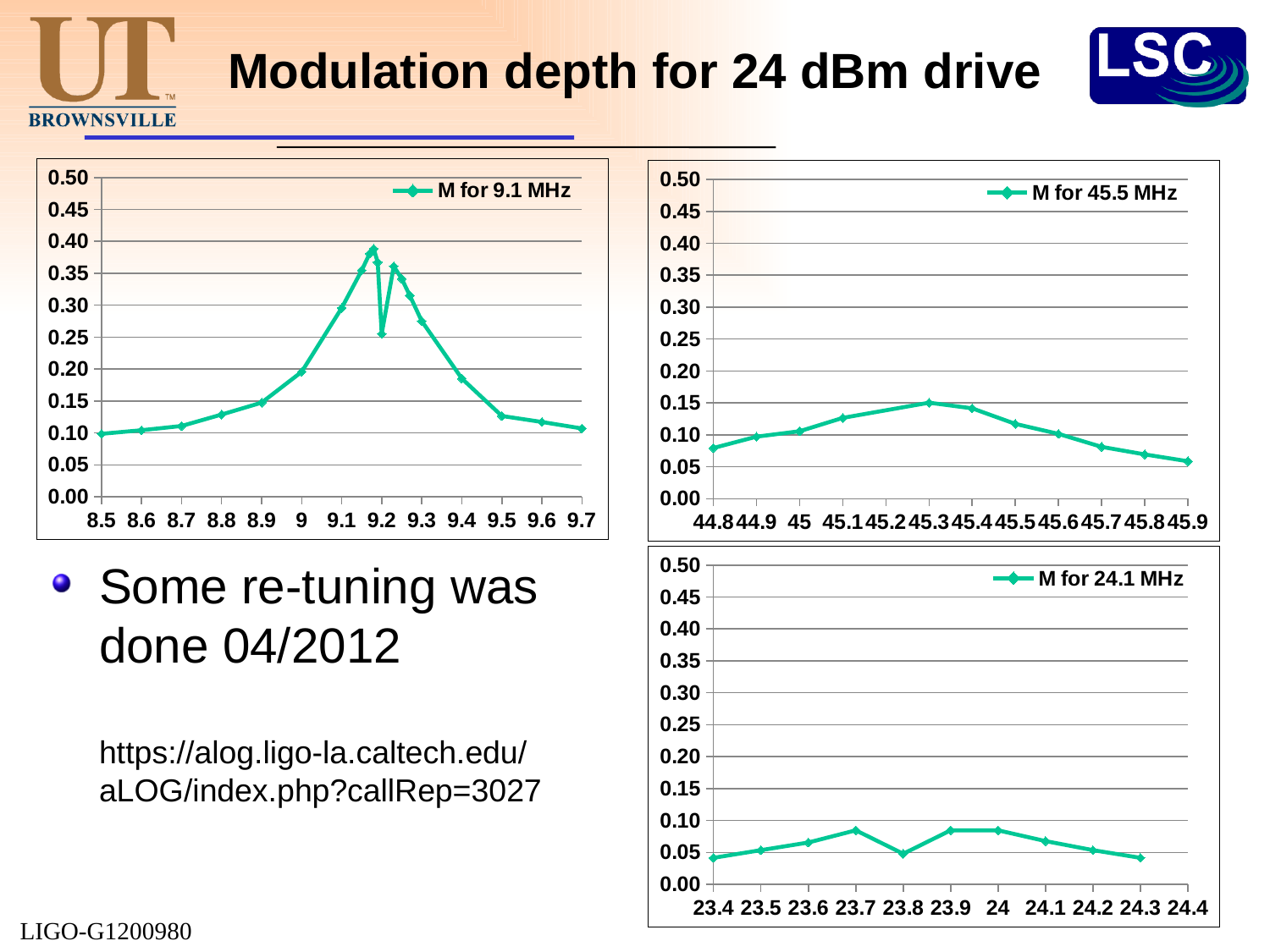
How many data points are plotted in the chart titled "M for 24.1 MHz"? 10 How many series does the legend of the chart titled "M for 45.5 MHz" list? 1 In the chart titled "M for 45.5 MHz", is the value at 45.3 greater or less than 0.10? greater In the chart titled "M for 9.1 MHz", is the value at 9 greater or less than 0.15? greater In the chart titled "M for 24.1 MHz", is the value at 23.7 greater or less than 0.10? less In the chart titled "M for 45.5 MHz", which is larger, the value at 44.8 or the value at 45.3? 45.3 What kind of chart is the chart titled "M for 9.1 MHz"? line chart In the chart titled "M for 45.5 MHz", do the values rise or fall from 45.4 to 45.9? fall In the chart titled "M for 24.1 MHz", which is larger, the value at 23.7 or the value at 23.8? 23.7